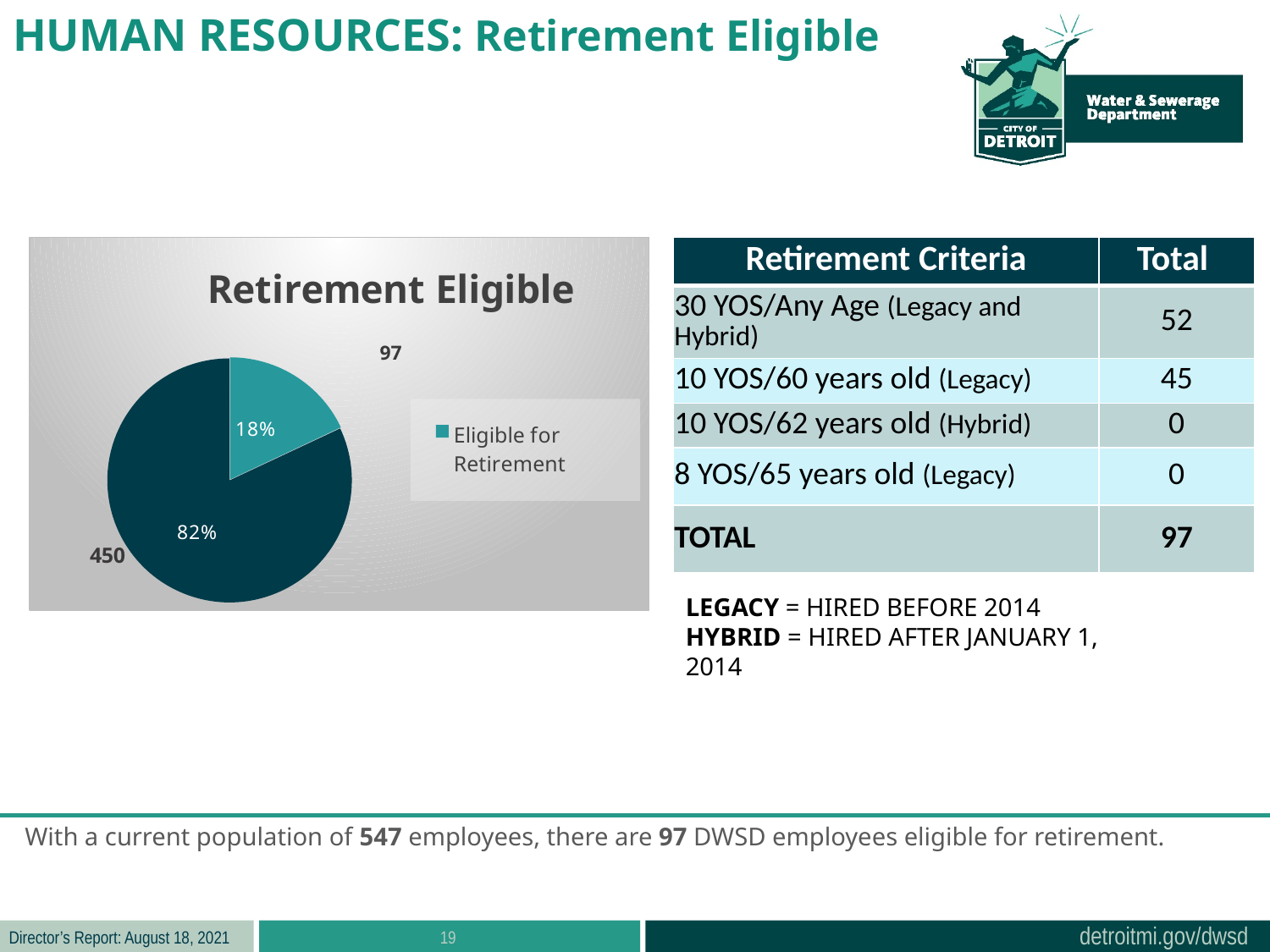
What is the total of the two values printed on the pie chart, 450 and 97? 547 What percentage is shown on the larger slice of the pie chart? 82% What number is printed next to the 'Eligible for Retirement' slice? 97 What is the title of the chart? Retirement Eligible What kind of chart is shown on the slide? pie chart How many slices does the pie chart have? 2 What is the legend entry shown on the chart? Eligible for Retirement What is the difference between the two values printed on the pie chart, 450 and 97? 353 How many entries does the chart legend list? 1 What number is printed next to the larger slice of the pie chart? 450 What percentage of the pie is labelled for the 'Eligible for Retirement' slice? 18% Which slice is larger: the 18% slice or the 82% slice? the 82% slice